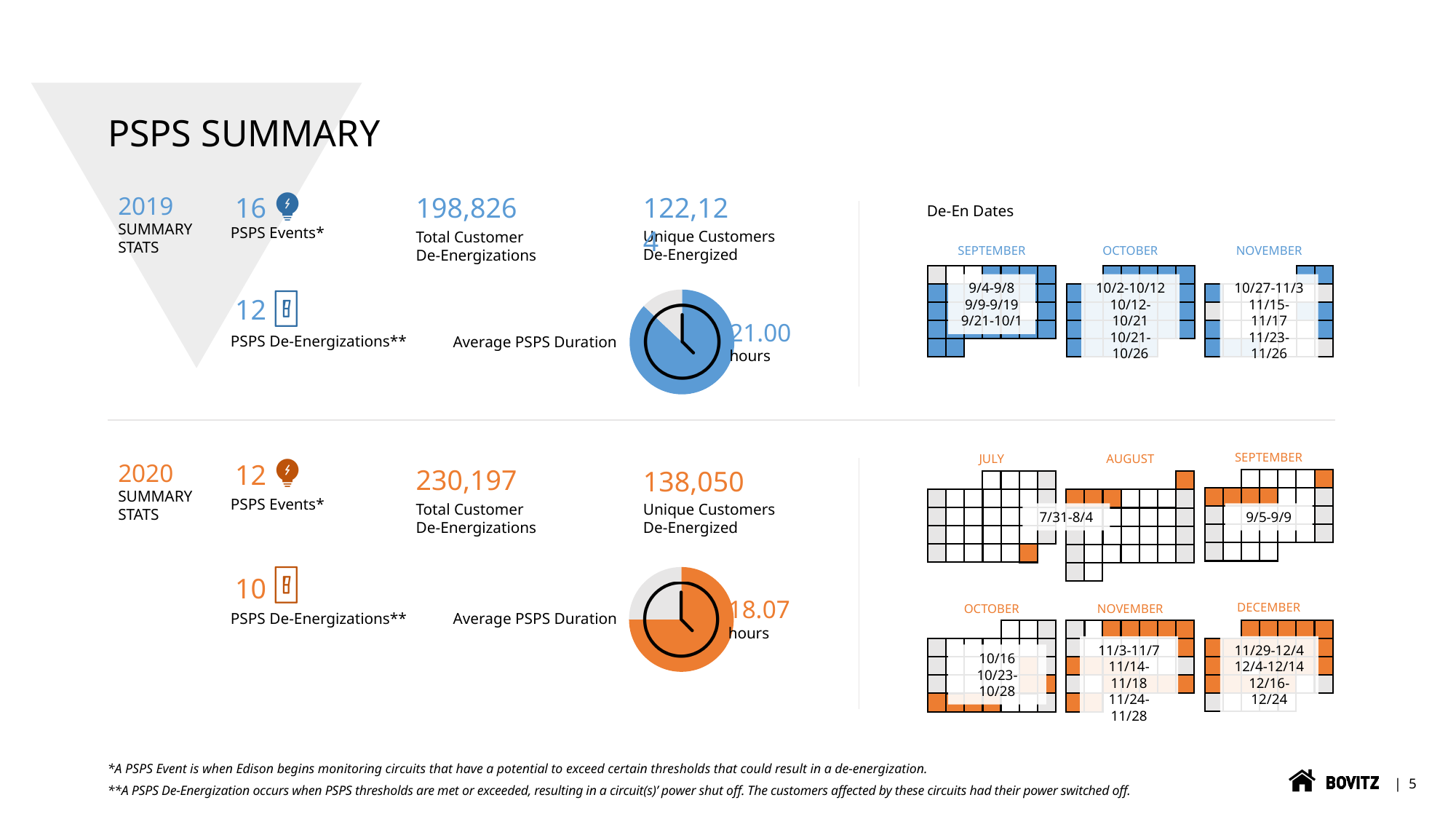
How many Average PSPS Duration charts are on the slide? 2 Which year's Average PSPS Duration chart shows the larger value, 2019 or 2020? 2019 What is the difference between the 2019 and 2020 Average PSPS Duration values shown on the charts? 2.93 hours What colour is the filled portion of the 2019 Average PSPS Duration chart? Blue What colour is the filled portion of the 2020 Average PSPS Duration chart? Orange On the 2020 Average PSPS Duration chart, what value is shown? 18.07 hours On the 2019 Average PSPS Duration chart, what value is shown? 21.00 hours Is the value on the 2020 Average PSPS Duration chart greater or less than 20 hours? less What kind of chart is used to show the Average PSPS Duration for each year? Donut (pie) chart with a clock icon Is the value on the 2019 Average PSPS Duration chart greater or less than 20 hours? greater